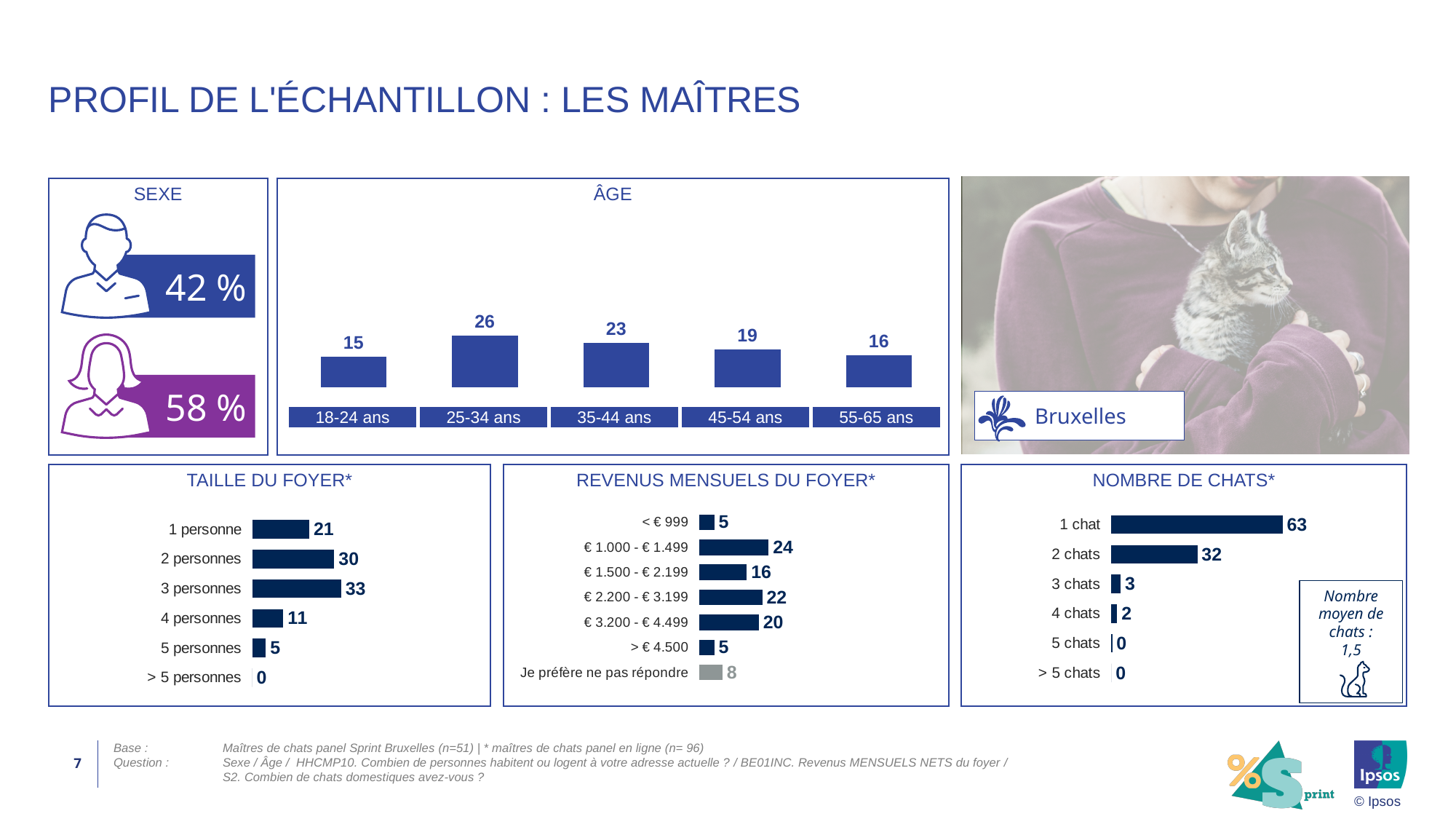
In the REVENUS MENSUELS DU FOYER* chart, which is larger: € 1.000 - € 1.499 or € 1.500 - € 2.199? € 1.000 - € 1.499 In the ÂGE chart, what is the difference between the values for 25-34 ans and 55-65 ans? 10 In the ÂGE chart, what is the value for 25-34 ans? 26 How many categories are shown in the REVENUS MENSUELS DU FOYER* chart? 7 In the NOMBRE DE CHATS* chart, what is the value for 1 chat? 63 In the TAILLE DU FOYER* chart, what is the value for 4 personnes? 11 In the ÂGE chart, which age group has the lowest value? 18-24 ans How many age categories are shown in the ÂGE chart? 5 In the TAILLE DU FOYER* chart, which category has the highest value? 3 personnes What kind of chart is the ÂGE chart? Bar chart In the REVENUS MENSUELS DU FOYER* chart, what is the value for € 2.200 - € 3.199? 22 In the NOMBRE DE CHATS* chart, what is the difference between the values for 1 chat and 2 chats? 31